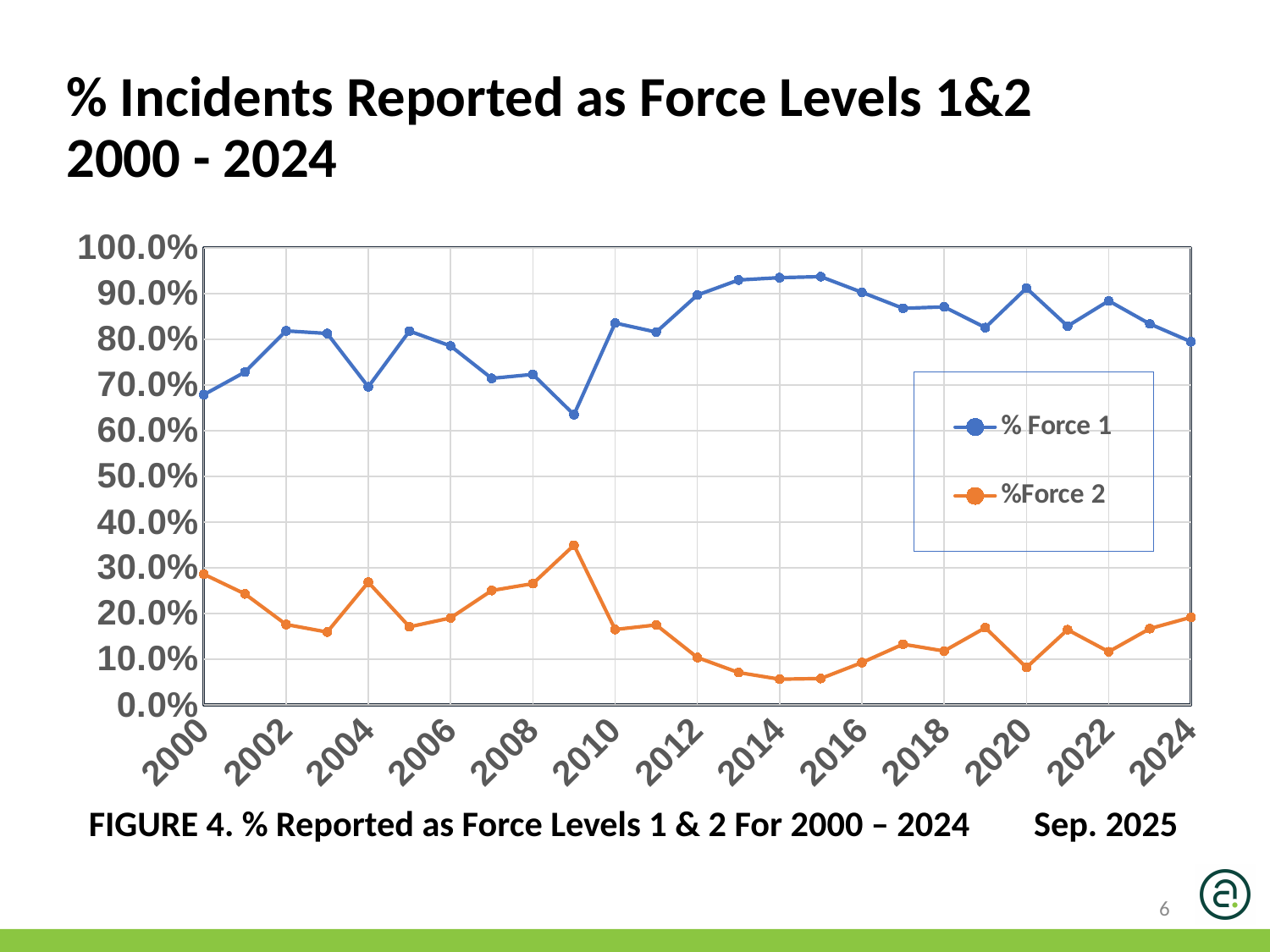
What colour is the line for %Force 2? orange Does the %Force 2 line rise or fall from 2009 to 2014? fall Is the % Force 1 value for 2009 greater or less than 70.0%? less Which series has the larger value in 2010, % Force 1 or %Force 2? % Force 1 Is the % Force 1 value for 2015 greater or less than 90.0%? greater In which year is the %Force 2 value highest? 2009 In which year is the % Force 1 value lowest? 2009 What kind of chart is shown on the slide? line chart Is the %Force 2 value for 2020 greater or less than 10.0%? less How many series does the legend list? 2 What are the two series named in the legend? % Force 1 and %Force 2